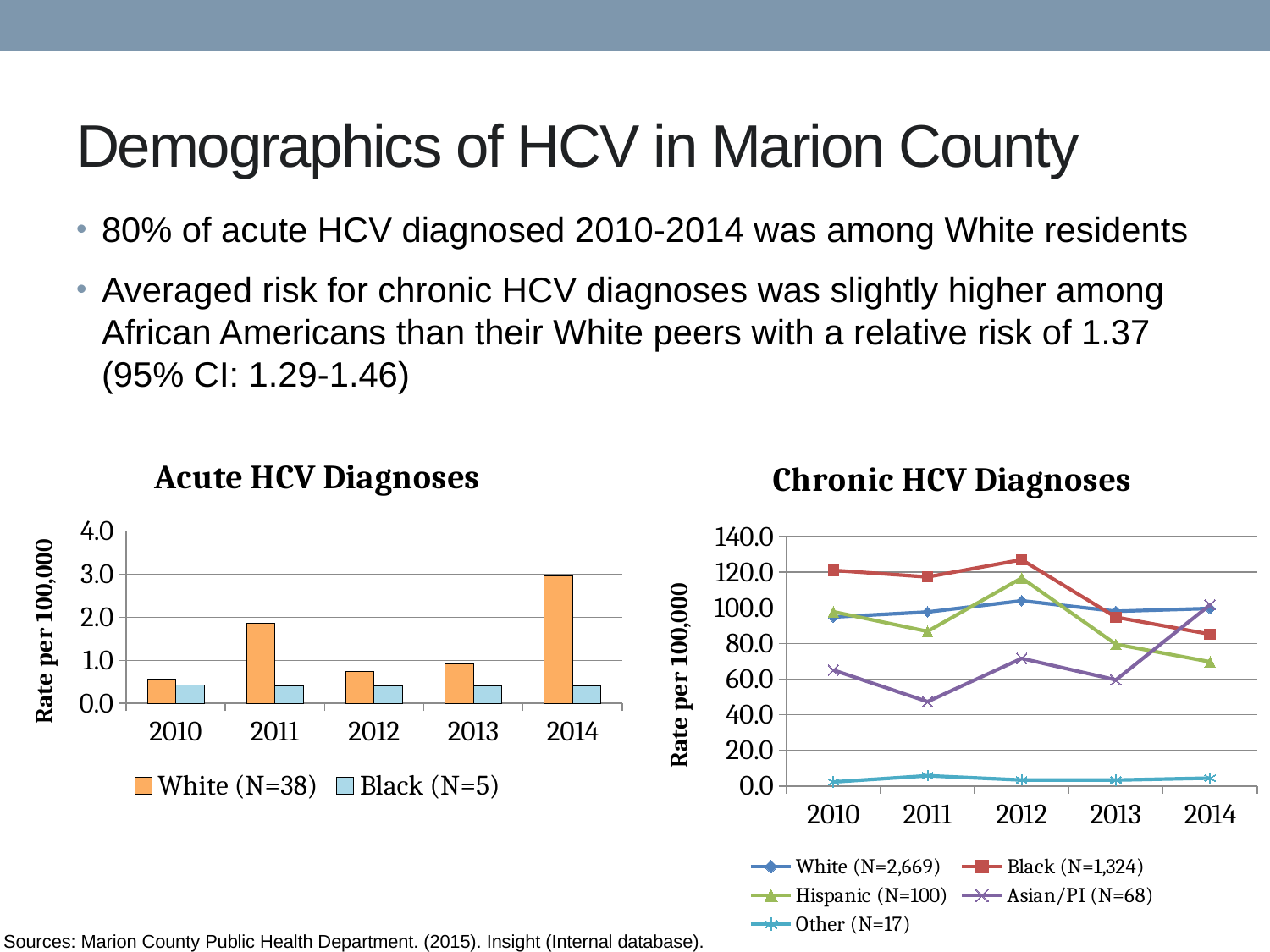
In the Acute HCV Diagnoses chart, is the value for White (N=38) in 2014 greater or less than 2.0? greater What kind of chart is the Chronic HCV Diagnoses chart? line chart In the Chronic HCV Diagnoses chart, is the value for Black (N=1,324) in 2012 greater or less than 120.0? greater In the Chronic HCV Diagnoses chart, does the Black (N=1,324) line rise or fall from 2012 to 2014? fall In the Acute HCV Diagnoses chart, how many series does the legend list? 2 What kind of chart is the Acute HCV Diagnoses chart? bar chart In the Chronic HCV Diagnoses chart, how many series does the legend list? 5 In the Acute HCV Diagnoses chart, which year has the highest rate for White (N=38)? 2014 In the Chronic HCV Diagnoses chart, which series has the lowest rates across all years? Other (N=17) In the Acute HCV Diagnoses chart, how many years are shown on the x axis? 5 In the Acute HCV Diagnoses chart, which is larger in 2011: White (N=38) or Black (N=5)? White (N=38) In the Acute HCV Diagnoses chart, is the value for White (N=38) in 2010 greater or less than 1.0? less